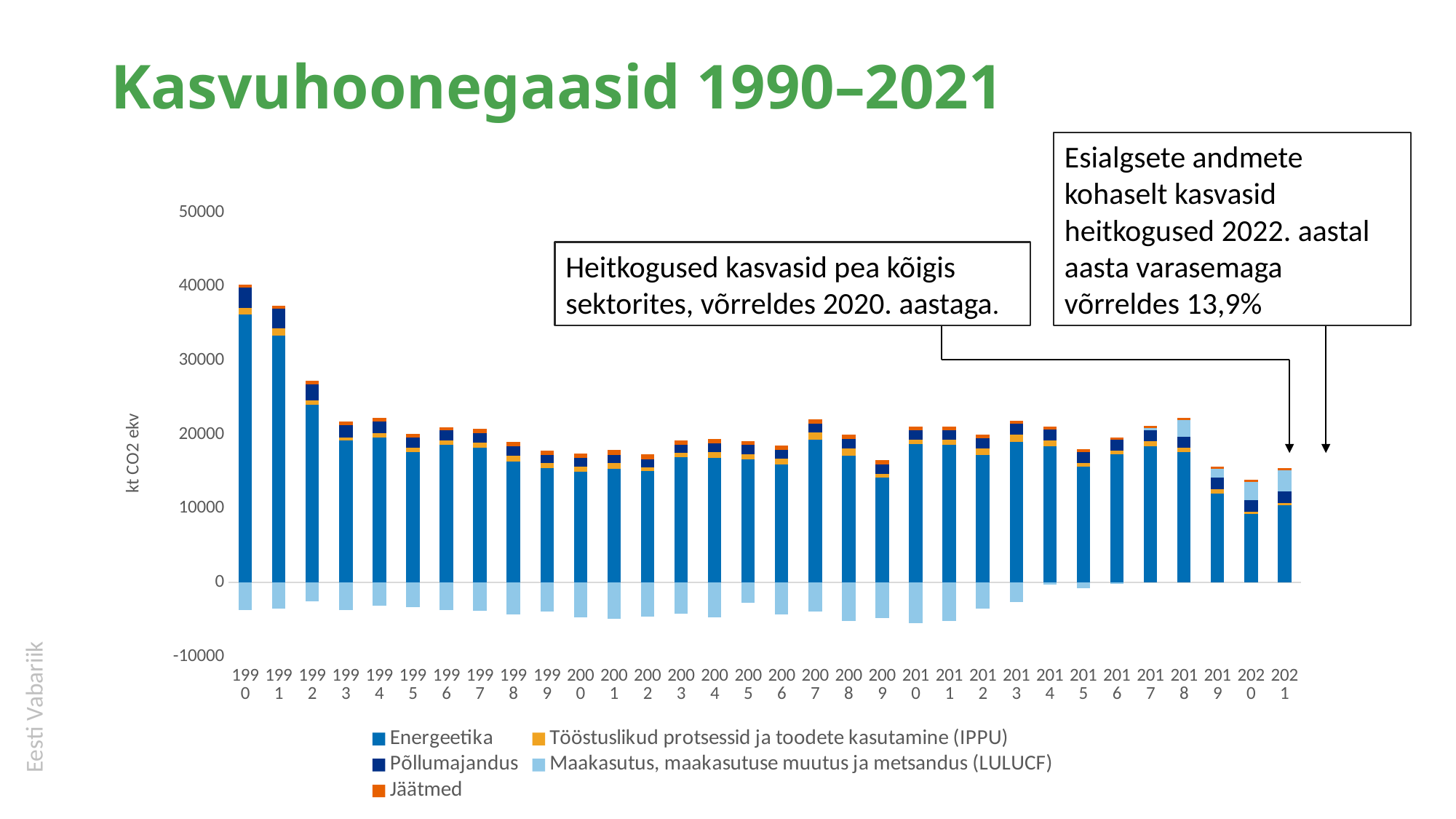
Do total emissions rise or fall from 1990 to 1999? Fall Which year has the lowest total positive emissions in the chart? 2020 What unit is shown on the y axis of the chart? kt CO2 ekv Which year has larger total emissions, 2019 or 2020? 2019 How many years are shown on the x axis of the chart? 32 Which year has the highest total emissions in the chart? 1990 Is the Energeetika value for 1990 greater or less than 30000? greater Is the total positive emissions value for 1992 greater or less than 20000? greater Which year has larger total emissions, 1990 or 1991? 1990 Is the total positive emissions value for 2020 greater or less than 20000? less What kind of chart is shown on the slide? Stacked bar chart How many series does the legend list? 5